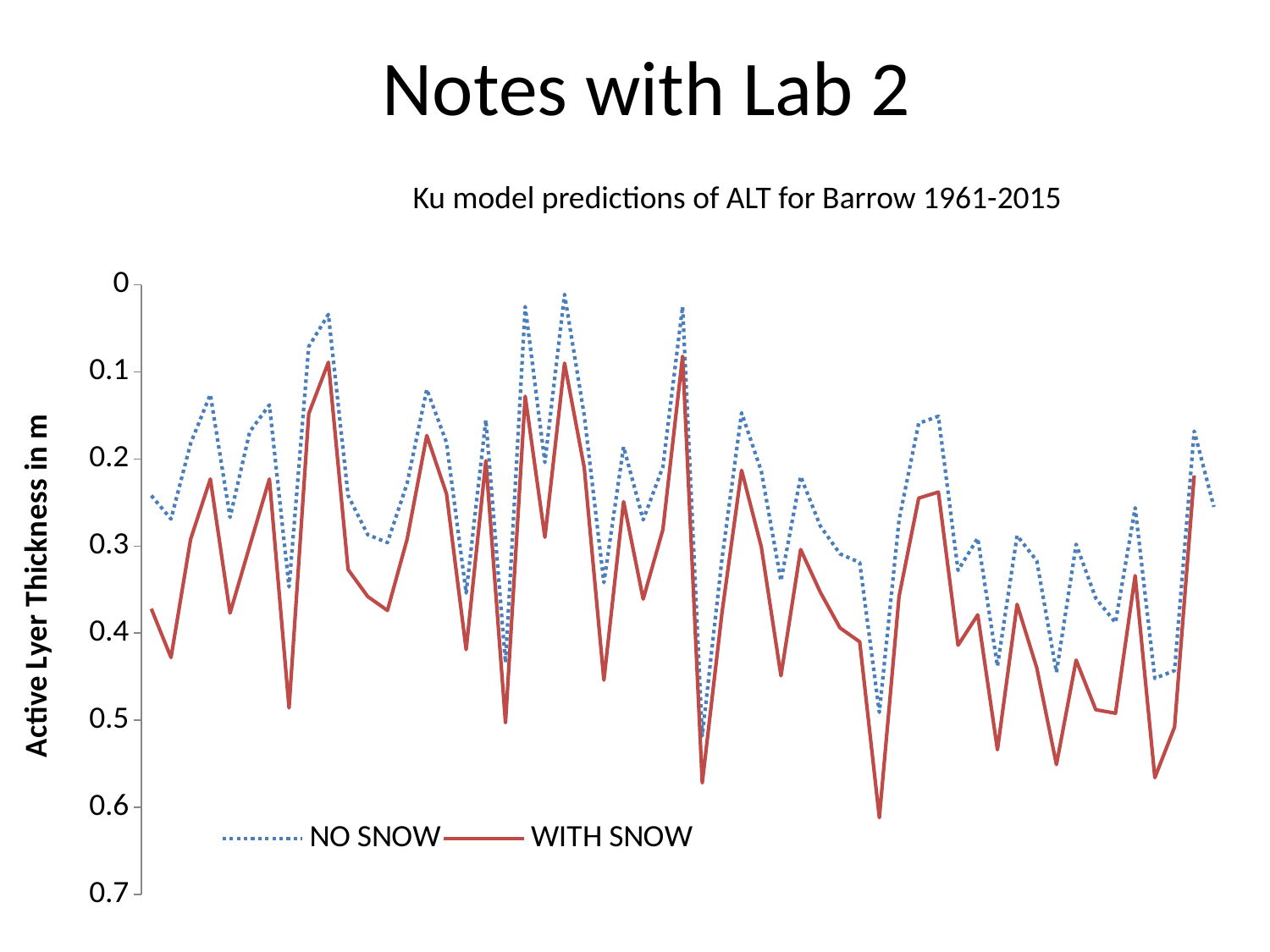
Which series reaches the deepest (largest) active layer thickness on the chart? WITH SNOW Is the smallest value reached by the WITH SNOW series greater or less than 0.2? less Which series has the larger active layer thickness values throughout the chart, NO SNOW or WITH SNOW? WITH SNOW Is the largest value reached by the NO SNOW series greater or less than 0.6? less What is the title of the chart? Ku model predictions of ALT for Barrow 1961-2015 How many series does the legend list? 2 Which series reaches the shallowest (smallest) active layer thickness on the chart? NO SNOW What is the label on the vertical axis of the chart? Active Lyer Thickness in m What kind of chart is shown on the slide? Line chart Is the largest value reached by the WITH SNOW series greater or less than 0.5? greater